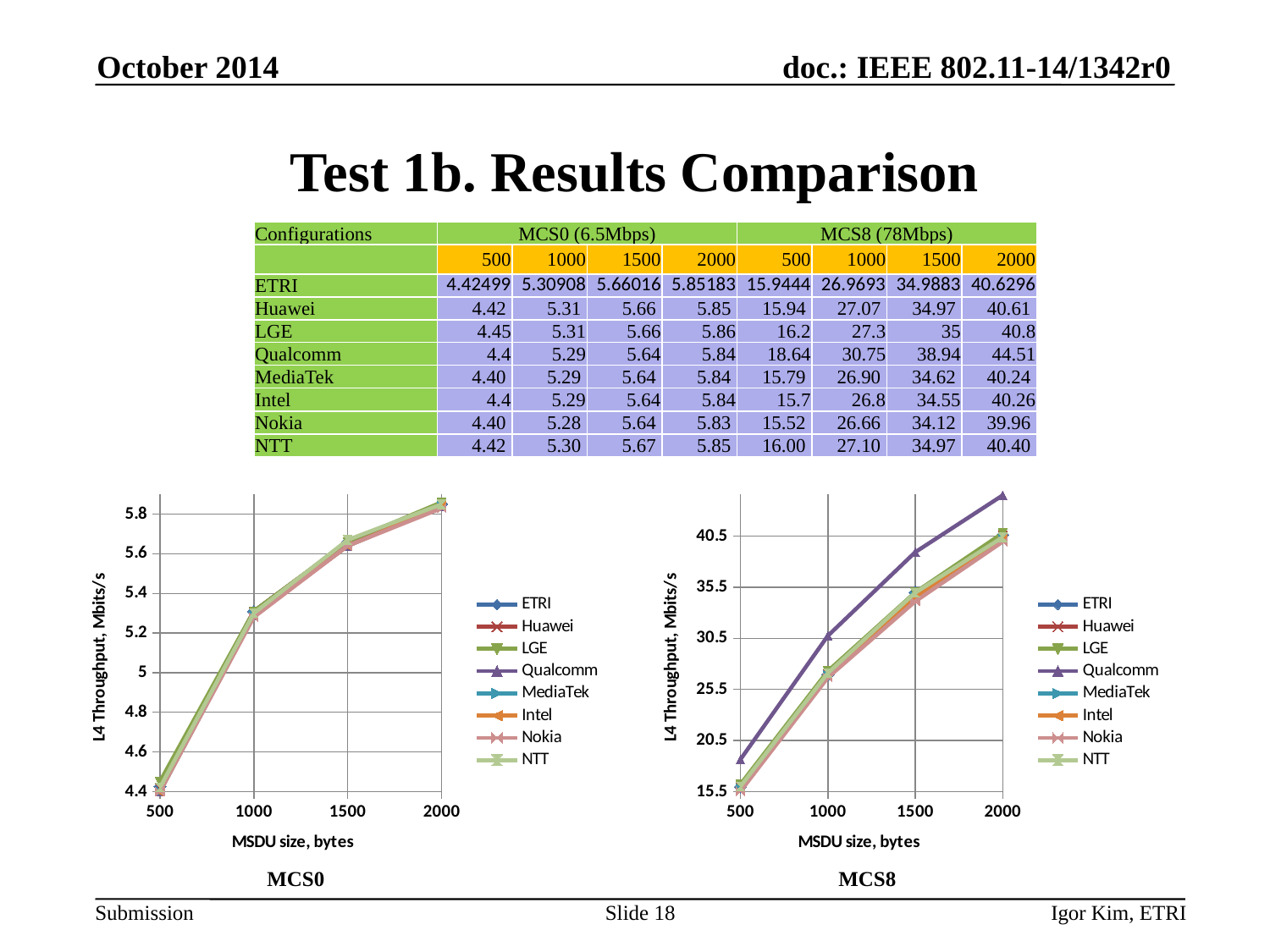
In the MCS0 chart, is the value for ETRI at MSDU size 500 greater or less than 4.6? less In the MCS8 chart, is the value for Qualcomm at MSDU size 1500 greater or less than 35.5? greater What is the x-axis label of the MCS8 chart? MSDU size, bytes In the MCS8 chart, do the throughput values rise or fall as MSDU size increases? rise In the MCS8 chart, is the value for Qualcomm at MSDU size 2000 greater or less than 40.5? greater In the MCS8 chart, which series has the highest value at MSDU size 2000? Qualcomm How many MSDU size points are plotted along the x axis of the MCS0 chart? 4 What is the y-axis label of the MCS0 chart? L4 Throughput, Mbits/s What kind of chart is the MCS0 chart on the left? line chart In the MCS8 chart, which is larger at MSDU size 1500: Qualcomm or Nokia? Qualcomm How many series does the legend of the MCS8 chart list? 8